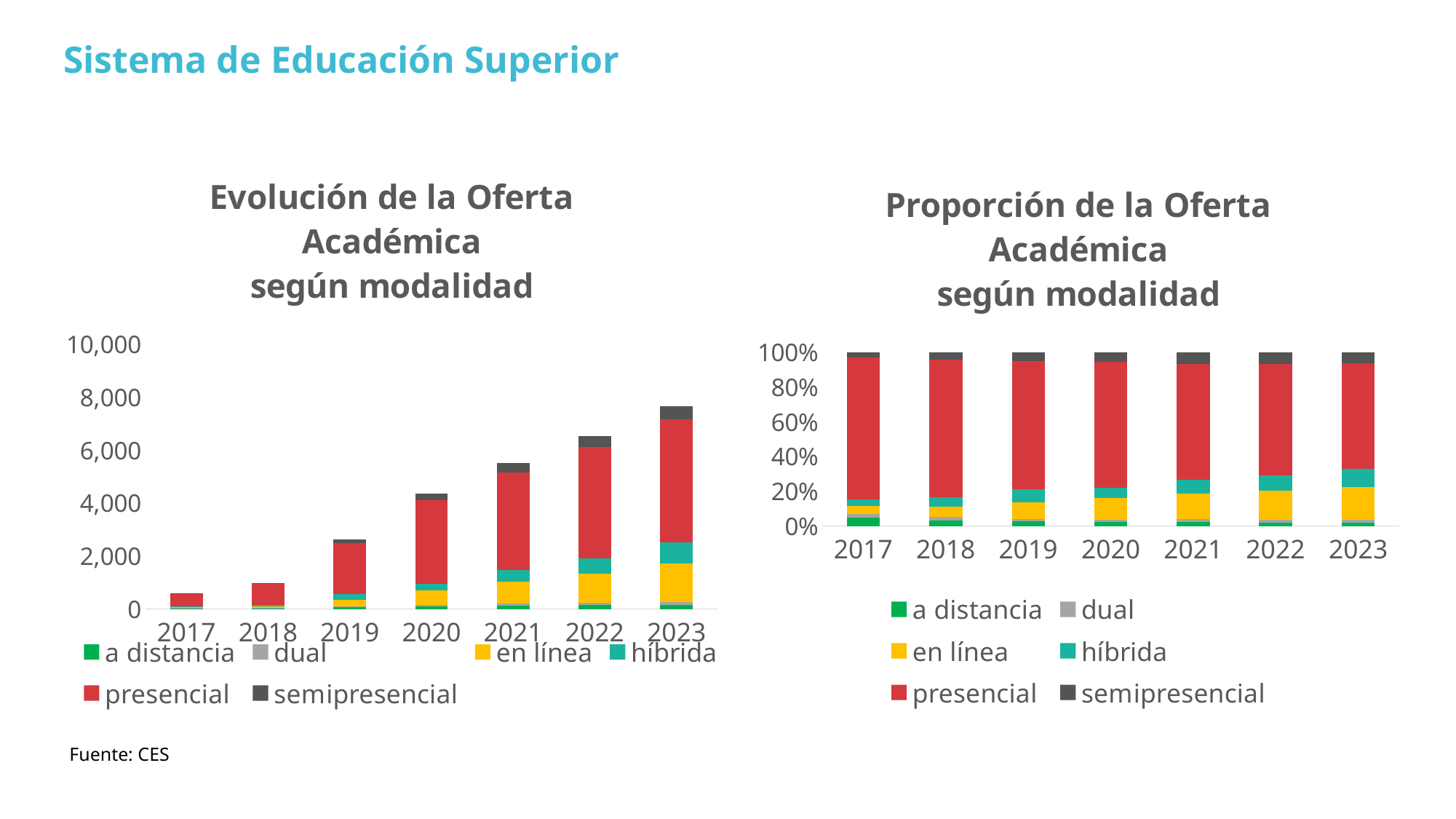
In the 'Evolución de la Oferta Académica según modalidad' chart, is the total bar for 2023 greater or less than 6,000? greater How many years are shown on the x axis of the 'Evolución de la Oferta Académica según modalidad' chart? 7 In the 'Evolución de la Oferta Académica según modalidad' chart, which total bar is taller, 2021 or 2022? 2022 In the 'Evolución de la Oferta Académica según modalidad' chart, is the total bar for 2020 greater or less than 6,000? less In the 'Proporción de la Oferta Académica según modalidad' chart, does the share of 'presencial' rise or fall from 2017 to 2023? fall In the 'Proporción de la Oferta Académica según modalidad' chart, which colour represents 'en línea' in the legend? yellow What type of chart is the 'Evolución de la Oferta Académica según modalidad' chart? stacked bar chart In the 'Evolución de la Oferta Académica según modalidad' chart, is the total bar for 2019 greater or less than 2,000? greater In the 'Evolución de la Oferta Académica según modalidad' chart, do the total bar heights rise or fall from 2017 to 2023? rise In the 'Evolución de la Oferta Académica según modalidad' chart, which year has the tallest total bar? 2023 How many series does the legend of the 'Evolución de la Oferta Académica según modalidad' chart list? 6 In the 'Evolución de la Oferta Académica según modalidad' chart, which year has the shortest total bar? 2017